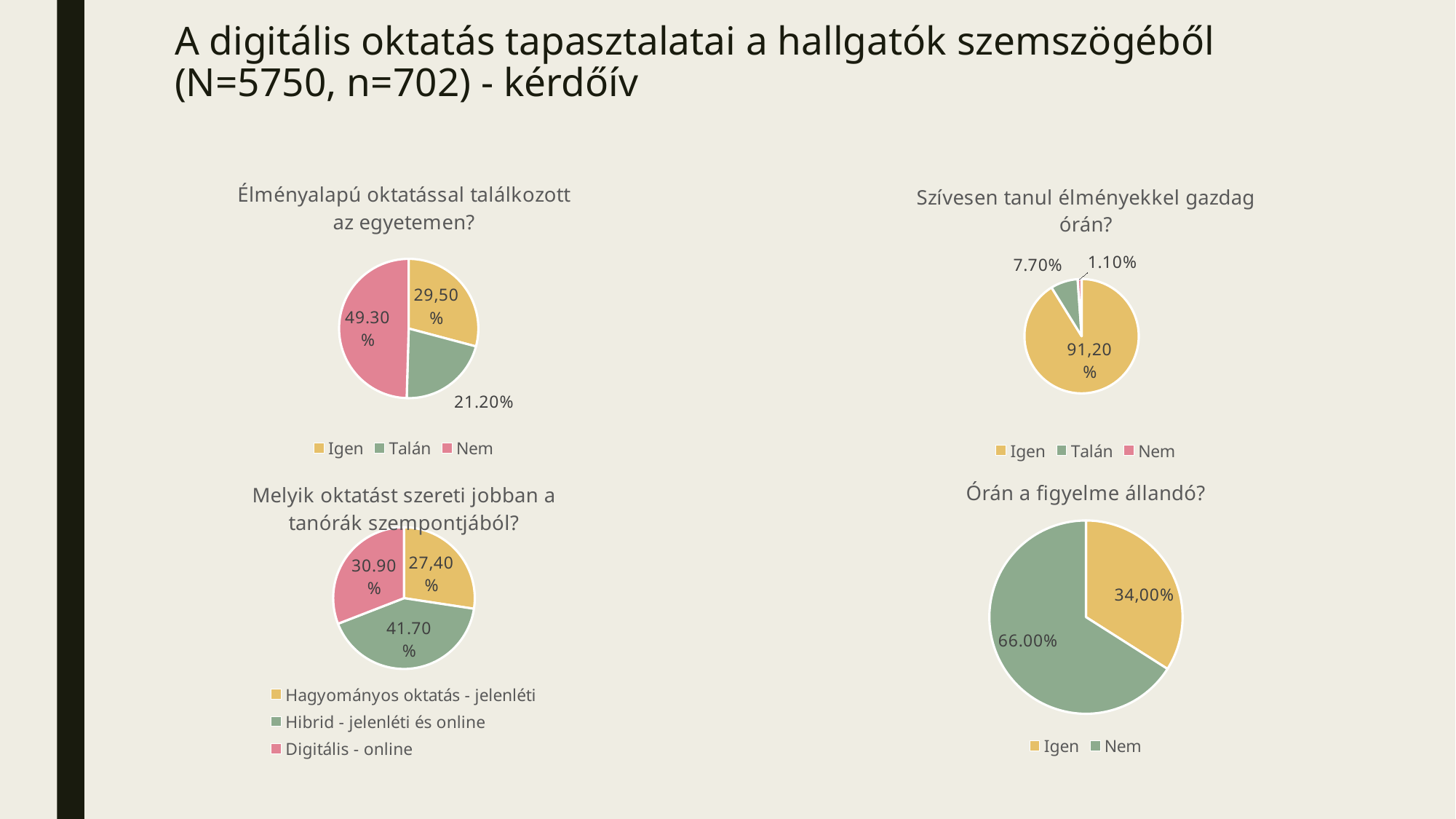
In the chart titled "Melyik oktatást szereti jobban a tanórák szempontjából?", what is the value for Hibrid - jelenléti és online? 41.70% In the chart titled "Élményalapú oktatással találkozott az egyetemen?", which category has the smallest share? Talán In the chart titled "Szívesen tanul élményekkel gazdag órán?", how many categories does the legend list? 3 In the chart titled "Órán a figyelme állandó?", what is the difference between Nem and Igen? 32.00% In the chart titled "Élményalapú oktatással találkozott az egyetemen?", what is the value for Nem? 49.30% In the chart titled "Szívesen tanul élményekkel gazdag órán?", what is the value for Igen? 91,20% In the chart titled "Órán a figyelme állandó?", what is the value for Nem? 66.00% In the chart titled "Melyik oktatást szereti jobban a tanórák szempontjából?", which category has the smallest share? Hagyományos oktatás - jelenléti In the chart titled "Szívesen tanul élményekkel gazdag órán?", what is the value for Nem? 1.10% In the chart titled "Melyik oktatást szereti jobban a tanórák szempontjából?", which is larger: Digitális - online or Hagyományos oktatás - jelenléti? Digitális - online In the chart titled "Élményalapú oktatással találkozott az egyetemen?", which category has the largest share? Nem What kind of chart is the chart titled "Órán a figyelme állandó?"? Pie chart